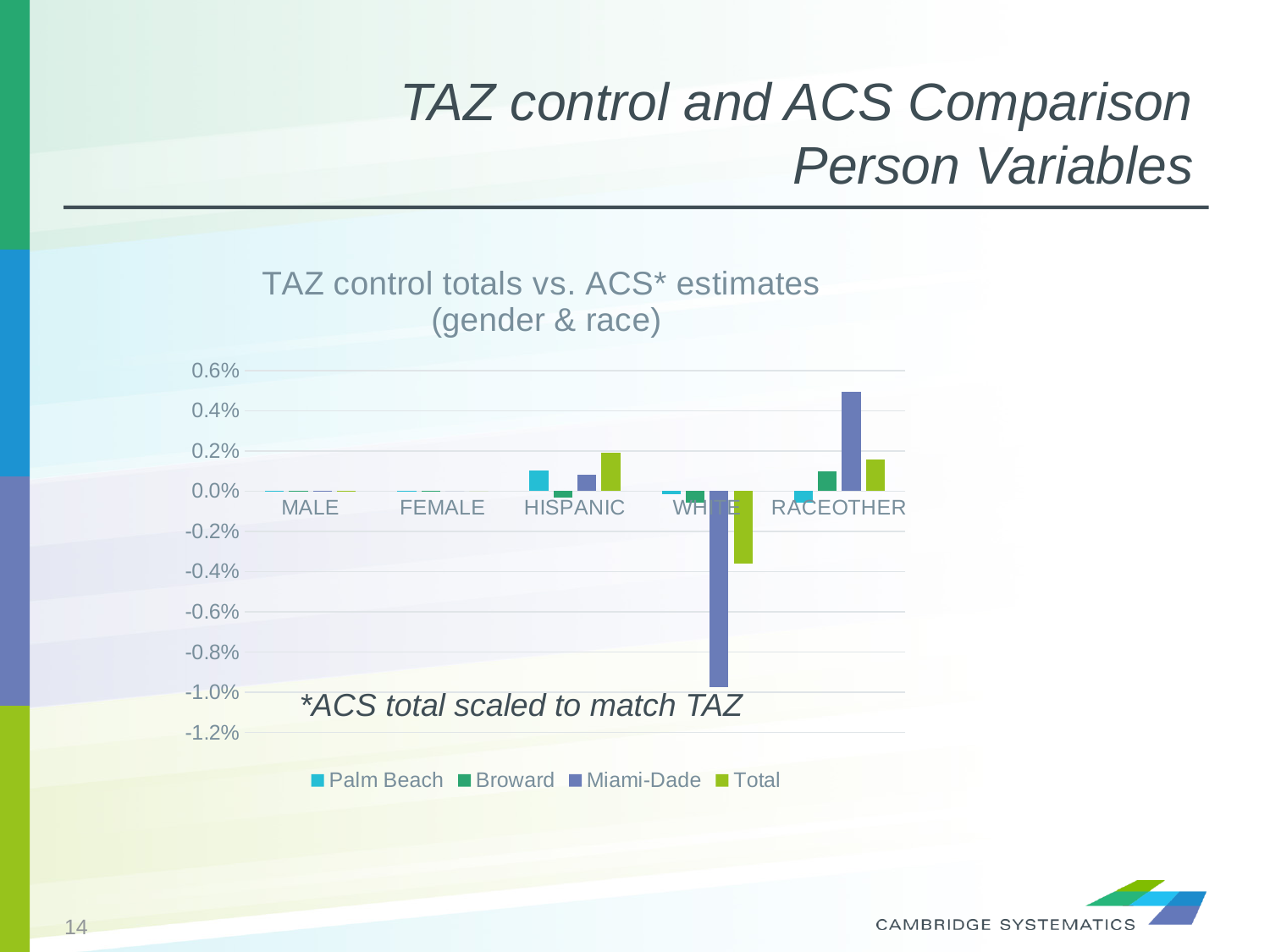
Is the Total value for HISPANIC greater or less than 0.0%? greater Is the Miami-Dade value for RACEOTHER greater or less than 0.4%? greater Is the Total value for WHITE greater or less than -0.2%? less For which category is the Miami-Dade value highest? RACEOTHER For the WHITE category, which is lower: the Miami-Dade value or the Total value? Miami-Dade What is the title of the chart? TAZ control totals vs. ACS* estimates (gender & race) What kind of chart is shown on the slide? bar chart How many series does the legend list? 4 Which series is shown in the legend between Broward and Total? Miami-Dade For which category is the Miami-Dade value lowest? WHITE How many categories are shown on the x axis? 5